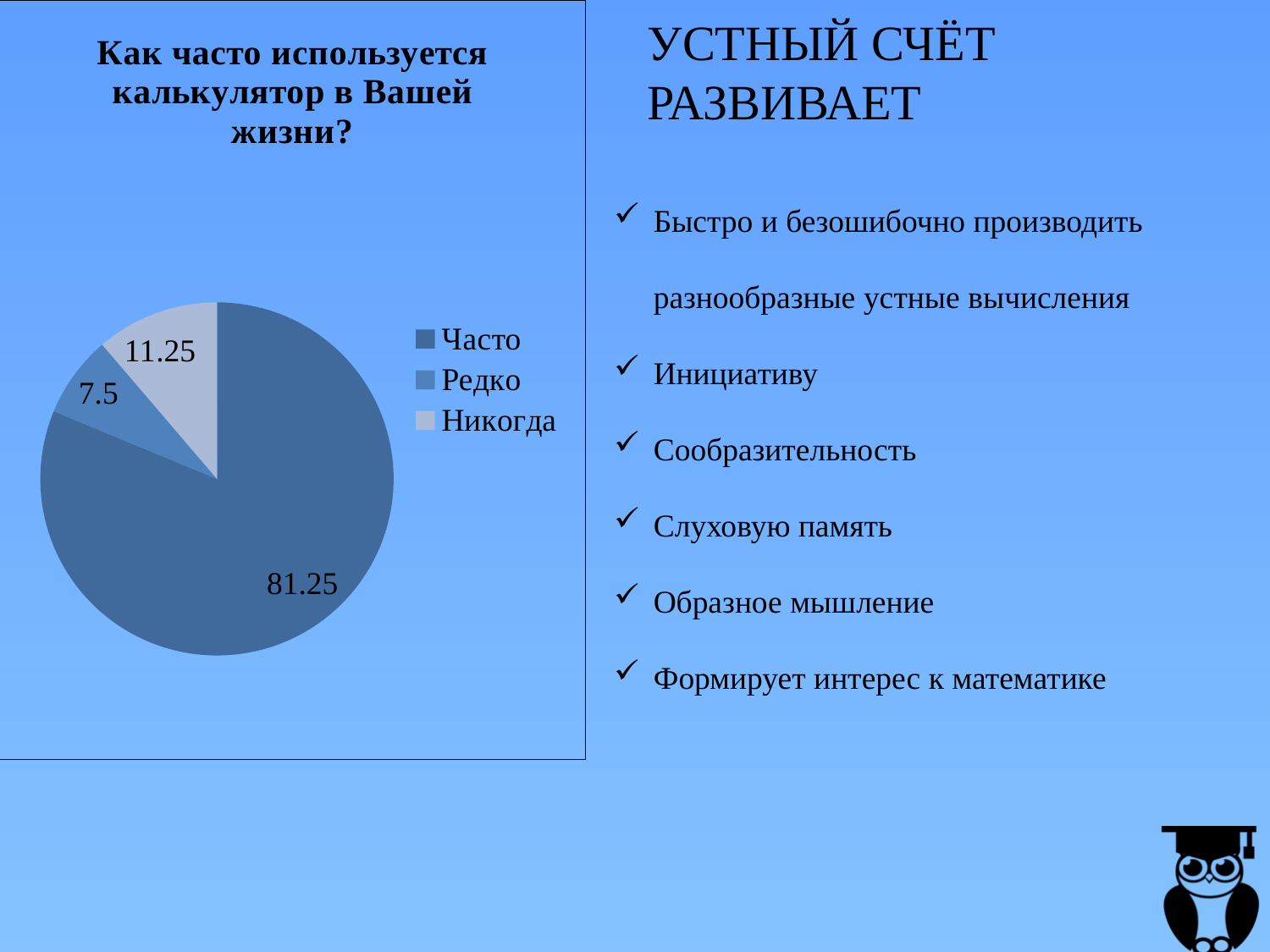
What is the value for Никогда in the pie chart? 11.25 What is the difference between the values for Часто and Никогда? 70 What are the legend entries of the pie chart, in order? Часто, Редко, Никогда How many categories does the pie chart have? 3 What is the value for Редко in the pie chart? 7.5 Which is larger, the value for Редко or the value for Никогда? Никогда Which category has the largest slice in the pie chart? Часто What is the value for Часто in the pie chart? 81.25 What type of chart is shown on the slide? pie chart Which category has the smallest slice in the pie chart? Редко What is the difference between the values for Никогда and Редко? 3.75 What is the title of the pie chart? Как часто используется калькулятор в Вашей жизни?